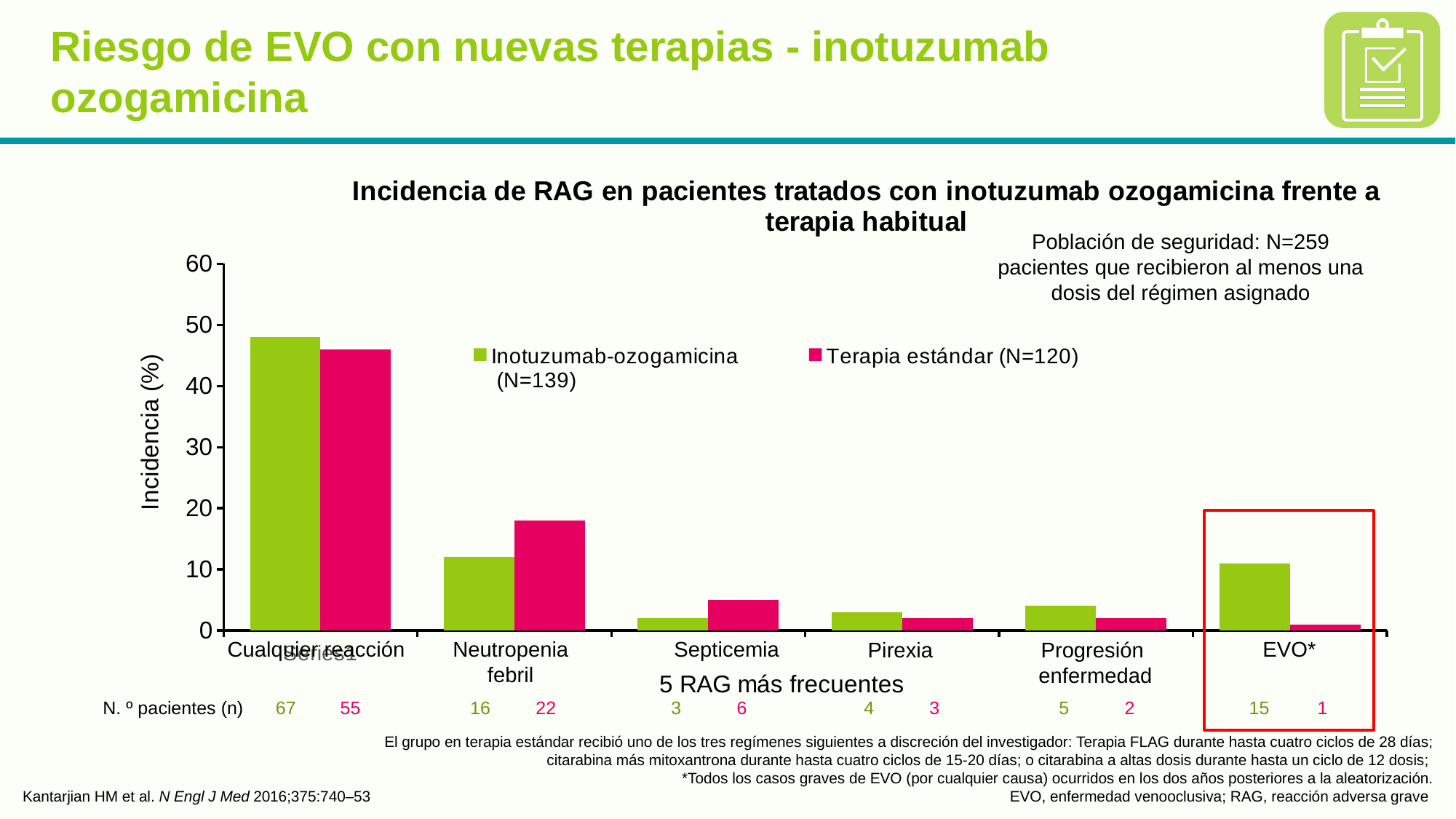
How many categories are shown along the x axis of the chart? 6 For Neutropenia febril, which series has the higher incidence? Terapia estándar (N=120) How many patients (n) had EVO* in the Inotuzumab-ozogamicina (N=139) group according to the row below the chart? 15 What is the label of the y axis of the chart? Incidencia (%) Which category has the lowest incidence for Terapia estándar (N=120)? EVO* For EVO*, which series has the higher incidence? Inotuzumab-ozogamicina (N=139) Which category has the highest incidence for Inotuzumab-ozogamicina (N=139)? Cualquier reacción Is the incidence for Cualquier reacción in the Inotuzumab-ozogamicina (N=139) series greater or less than 40? greater How many series does the chart legend list? 2 Is the incidence for Neutropenia febril in the Terapia estándar (N=120) series greater or less than 20? less What kind of chart is shown on the slide? bar chart